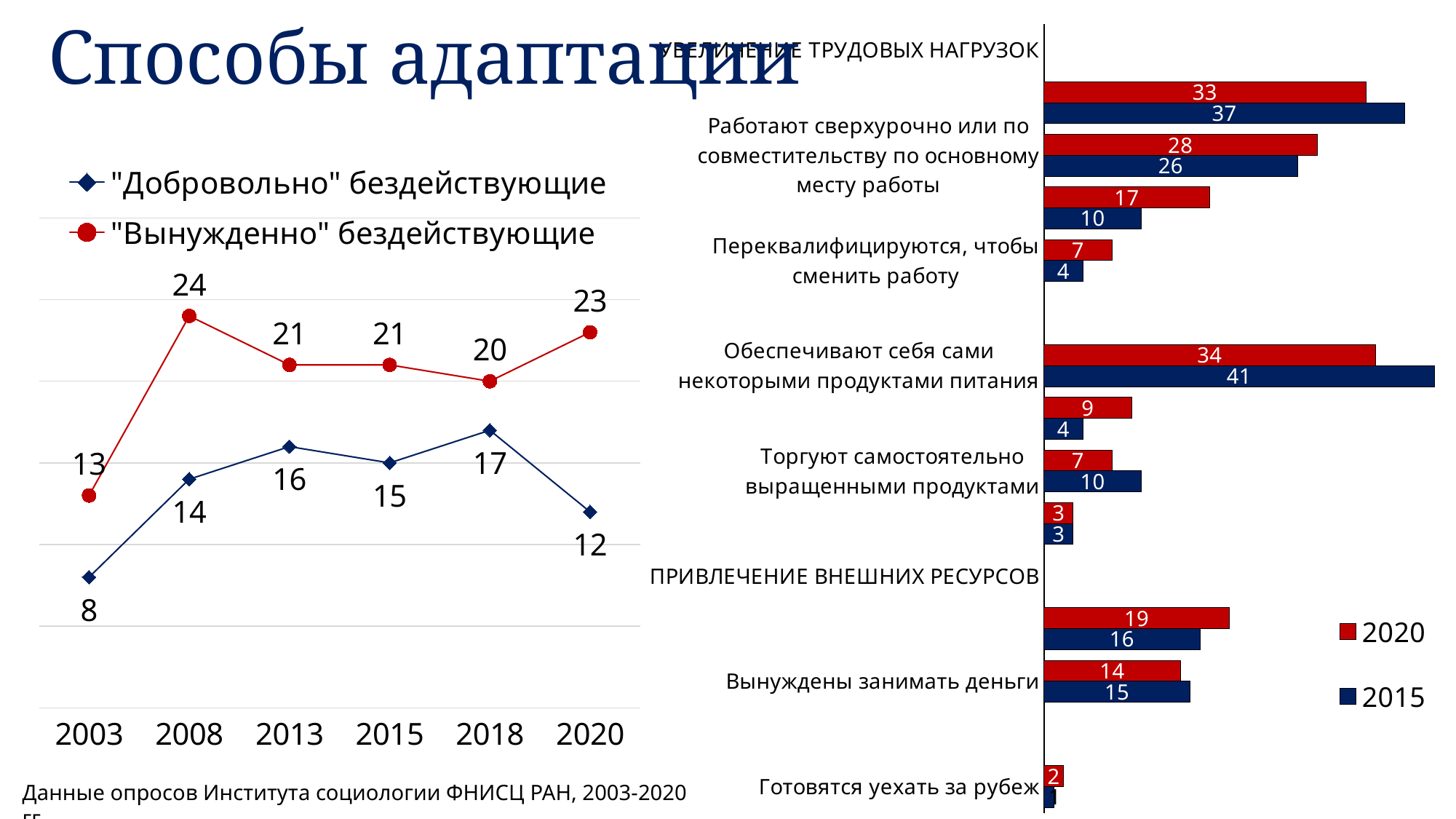
On the left line chart, what is the value for "Добровольно" бездействующие in 2020? 12 On the left line chart, how many years are shown on the x axis? 6 On the left line chart, in which year is the "Добровольно" бездействующие series at its highest? 2018 On the right bar chart, what is the 2015 value for "Обеспечивают себя сами некоторыми продуктами питания"? 41 On the right bar chart, what is the 2020 value for "Готовятся уехать за рубеж"? 2 On the left line chart, what is the value for "Вынужденно" бездействующие in 2008? 24 On the right bar chart, which colour represents 2020 in the legend? red On the right bar chart, which year has the larger value for "Обеспечивают себя сами некоторыми продуктами питания", 2020 or 2015? 2015 On the left line chart, what is the difference between the two series in 2003? 5 What kind of chart is the chart on the left of the slide? line chart On the left line chart, how many series does the legend list? 2 On the left line chart, in which year is the "Вынужденно" бездействующие series at its lowest? 2003